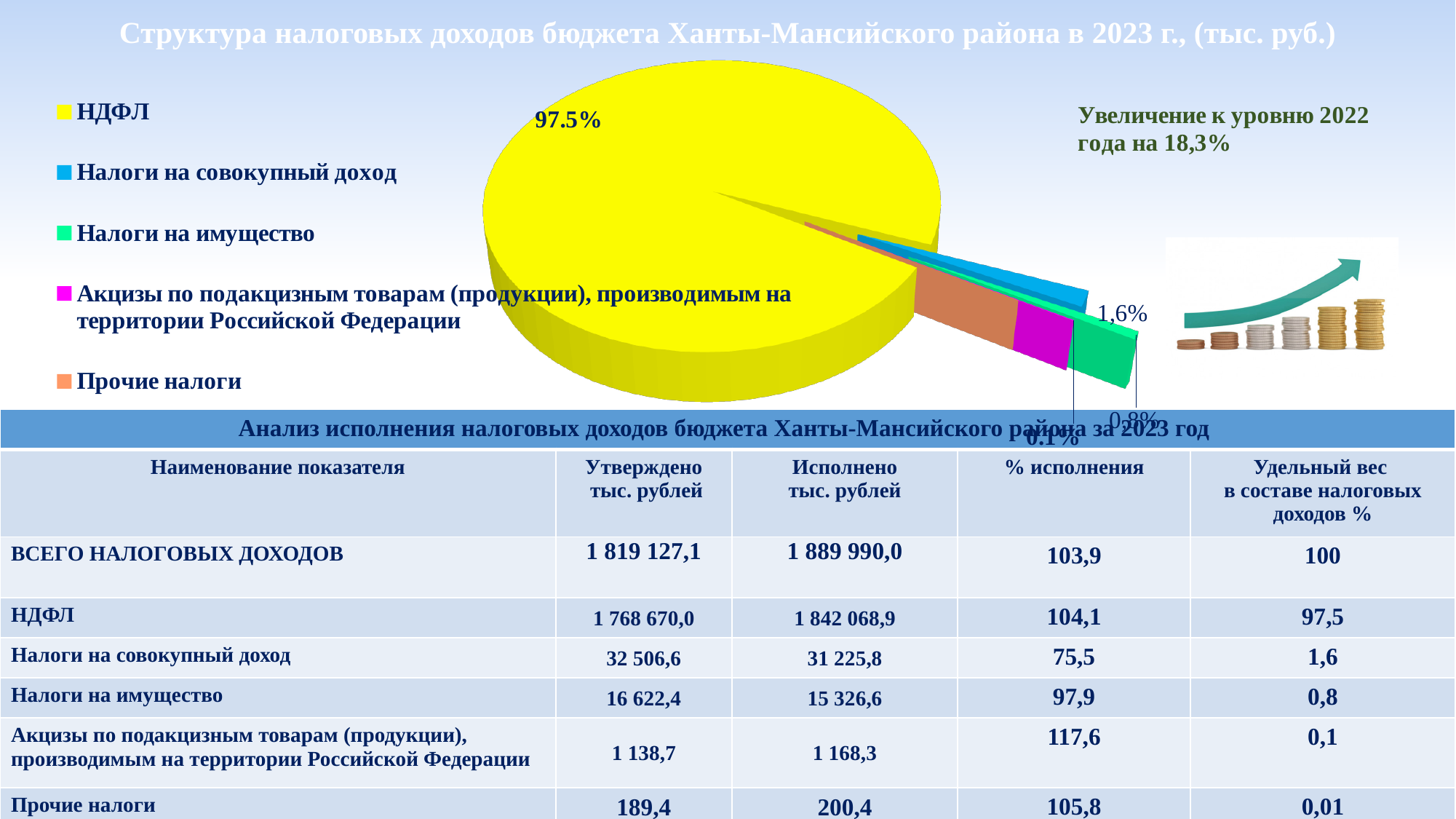
What is the title of the pie chart? Структура налоговых доходов бюджета Ханты-Мансийского района в 2023 г., (тыс. руб.) Which legend entry of the pie chart is shown in magenta? Акцизы по подакцизным товарам (продукции), производимым на территории Российской Федерации Which category has the largest slice in the pie chart? НДФЛ What kind of chart is shown on the slide? pie chart Which is larger in the pie chart: the slice for Налоги на совокупный доход or the slice for Акцизы по подакцизным товарам? Налоги на совокупный доход What share of the pie chart is labelled for Акцизы по подакцизным товарам (продукции), производимым на территории Российской Федерации? 0.1% How many categories does the pie chart's legend list? 5 What is the difference between the НДФЛ share and the Налоги на совокупный доход share in the pie chart? 95.9% Is the share for НДФЛ in the pie chart greater or less than 90%? greater What colour is the НДФЛ slice in the pie chart? yellow What share of the pie chart does НДФЛ account for? 97.5% What share of the pie chart is labelled for Налоги на совокупный доход? 1,6%